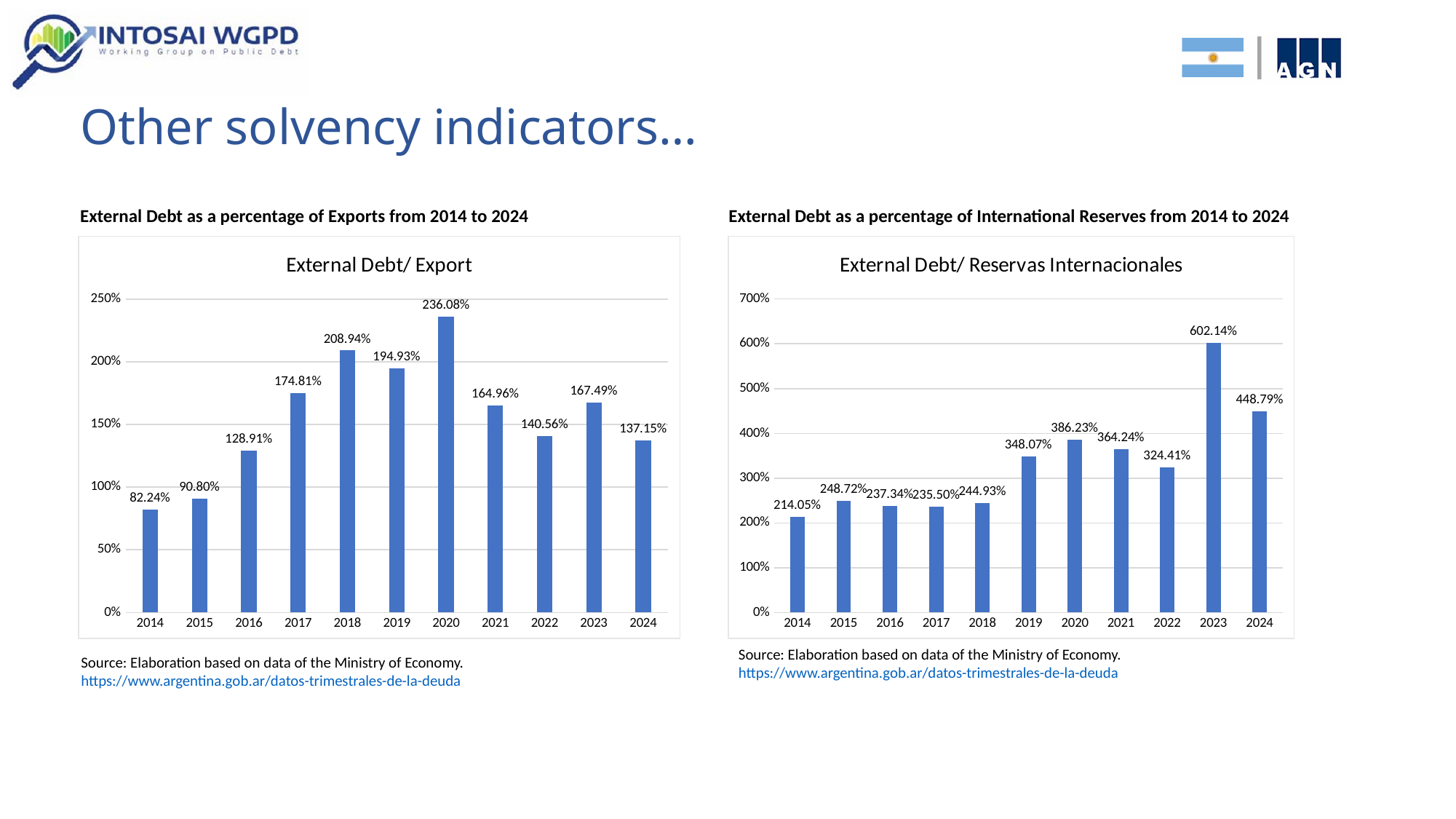
In the 'External Debt/ Reservas Internacionales' chart, what is the value for 2023? 602.14% In the 'External Debt/ Export' chart, how many years are plotted? 11 In the 'External Debt/ Export' chart, do values rise or fall from 2014 to 2020? rise In the 'External Debt/ Export' chart, which is larger, the value for 2021 or the value for 2023? 2023 In the 'External Debt/ Reservas Internacionales' chart, is the value for 2022 greater or less than 300%? greater What kind of chart is the 'External Debt/ Reservas Internacionales' chart? bar chart In the 'External Debt/ Export' chart, which year has the lowest value? 2014 In the 'External Debt/ Export' chart, what is the value for 2020? 236.08% In the 'External Debt/ Reservas Internacionales' chart, what is the value for 2014? 214.05% In the 'External Debt/ Reservas Internacionales' chart, which year has the highest value? 2023 In the 'External Debt/ Export' chart, what is the difference between the 2018 and 2019 values? 14.01% In the 'External Debt/ Reservas Internacionales' chart, what is the difference between the 2023 and 2024 values? 153.35%